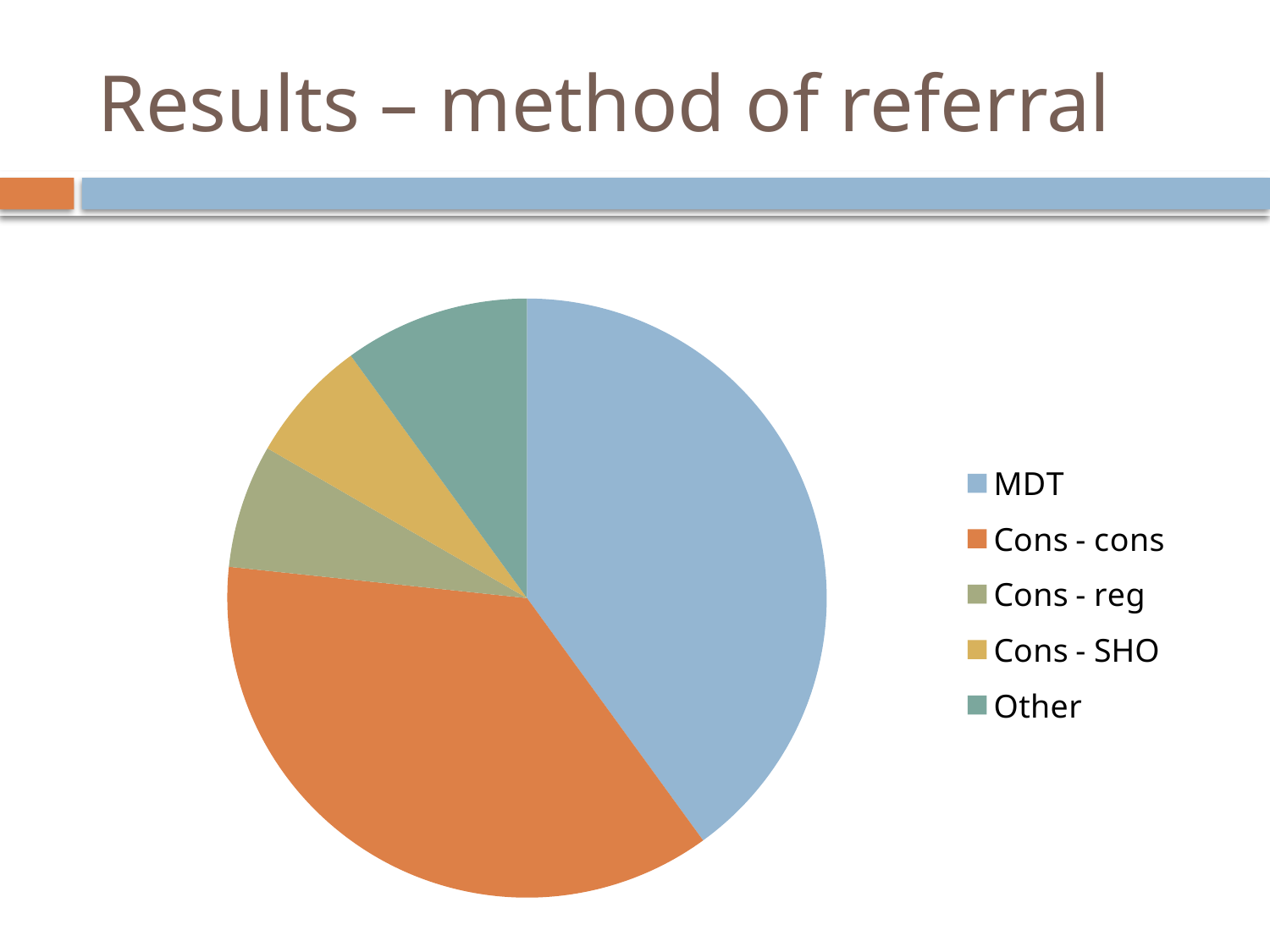
Which is larger, the Other slice or the Cons - reg slice? Other What colour is the MDT slice in the pie chart? Blue Which category has the largest slice of the pie chart? MDT Which is larger, the Cons - cons slice or the Other slice? Cons - cons Which is larger, the Cons - cons slice or the Cons - SHO slice? Cons - cons How many categories (slices) does the pie chart have? 5 What is the title of the slide containing the pie chart? Results – method of referral What kind of chart is shown on the slide? Pie chart